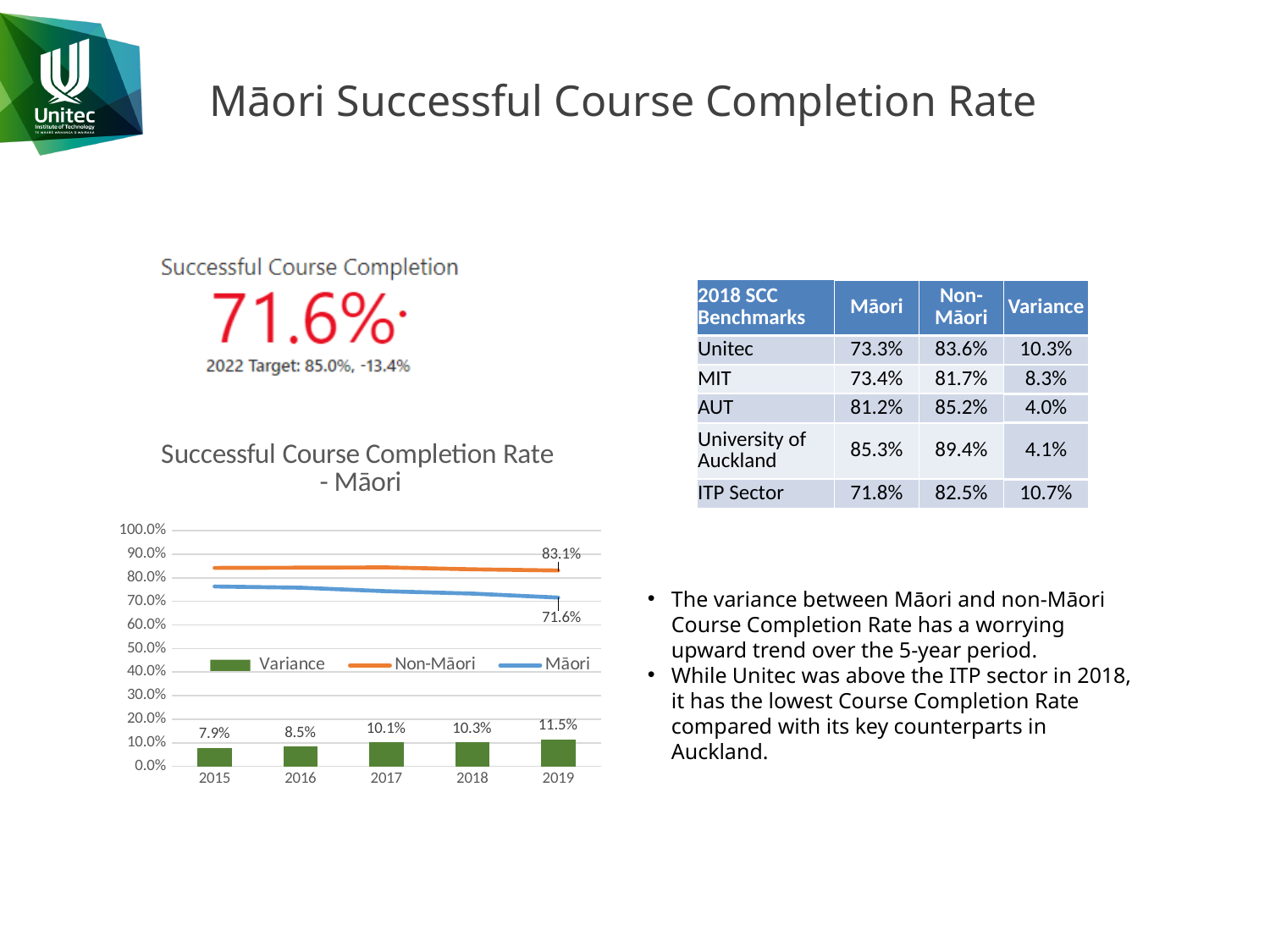
In which year is the Variance bar lowest in the Successful Course Completion Rate - Māori chart? 2015 Is the Māori completion rate for 2015 in the chart greater or less than 70.0%? greater What is the Māori successful course completion rate shown for 2019 in the chart? 71.6% How many series does the legend of the Successful Course Completion Rate - Māori chart list? 3 Does the Variance series rise or fall from 2015 to 2019 in the Successful Course Completion Rate - Māori chart? rise How many years are shown on the x axis of the Successful Course Completion Rate - Māori chart? 5 What is the Variance value for 2017 in the Successful Course Completion Rate - Māori chart? 10.1% What is the difference between the Variance values for 2019 and 2015 in the chart? 3.6% What is the Non-Māori successful course completion rate shown for 2019 in the chart? 83.1% Which is larger in the chart, the Variance for 2016 or the Variance for 2018? 2018 In which year is the Variance bar highest in the Successful Course Completion Rate - Māori chart? 2019 What is the Variance value for 2015 in the Successful Course Completion Rate - Māori chart? 7.9%